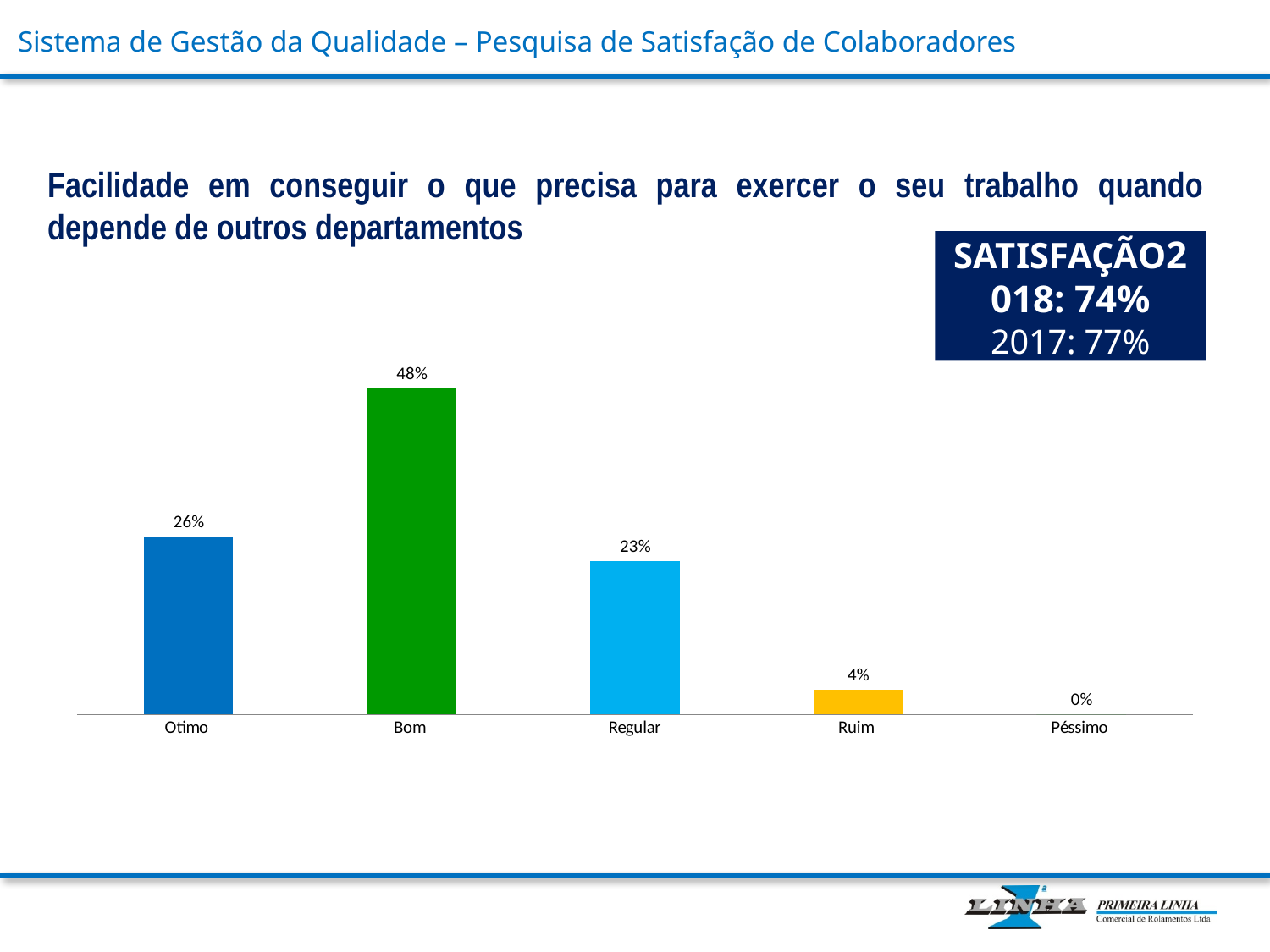
What is the difference between the values for Bom and Otimo? 22% What is the value for Regular? 23% How many categories are shown on the x axis? 5 What is the value for Ruim? 4% Which is larger, the value for Otimo or the value for Regular? Otimo Which category has the lowest value? Péssimo What is the value for Otimo? 26% What kind of chart is shown on the slide? Bar chart What is the value for Bom? 48% Which category has the highest value? Bom What colour is the bar for Bom? Green What is the value for Péssimo? 0%